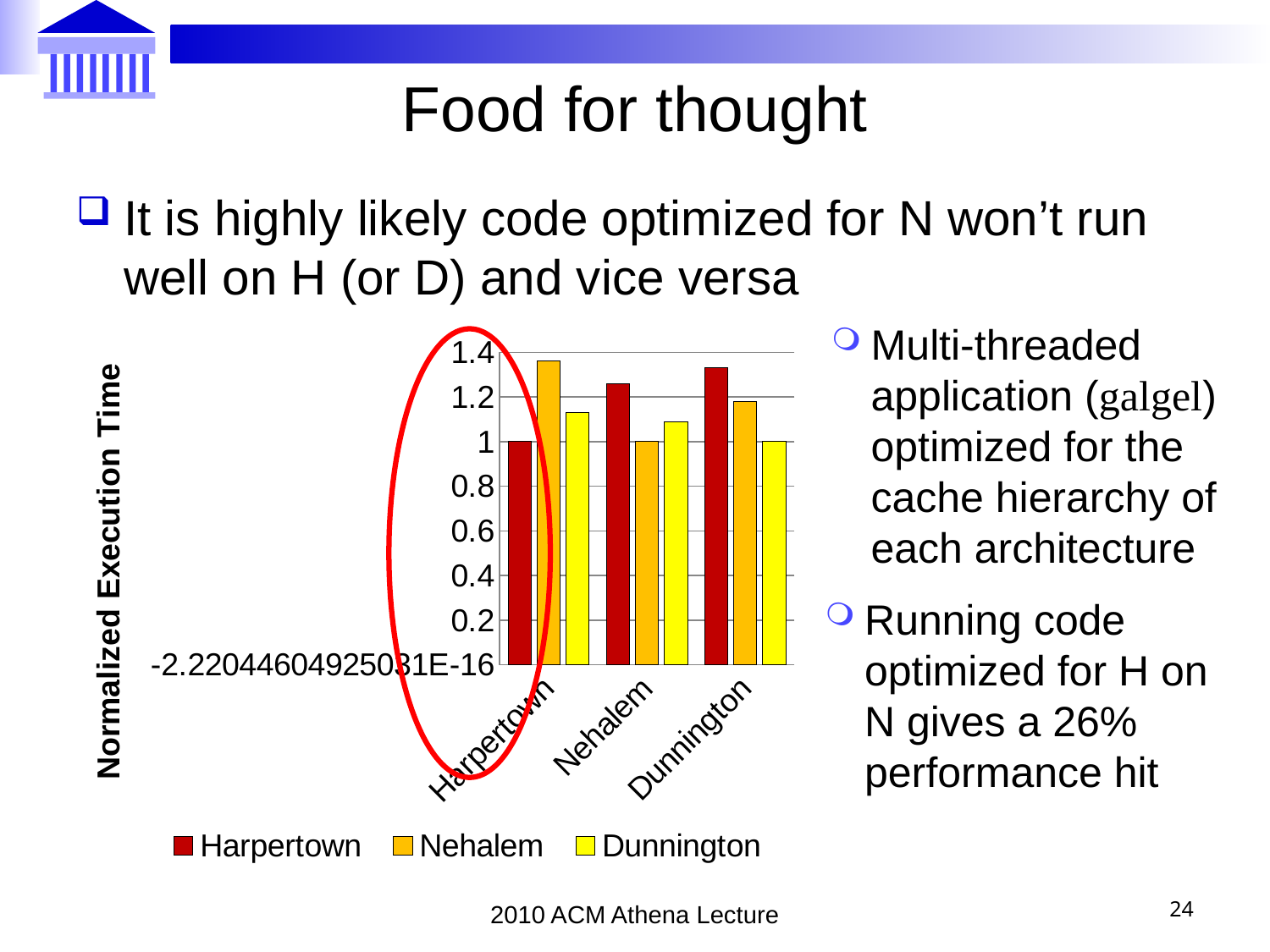
What is the value of the Harpertown series for the Harpertown category? 1 How many series does the chart legend list? 3 Is the value of the Nehalem series for the Harpertown category greater or less than 1.2? greater What is the value of the Nehalem series for the Nehalem category? 1 What is the value of the Dunnington series for the Dunnington category? 1 Is the value of the Nehalem series for the Dunnington category greater or less than 1? greater What kind of chart is shown on the slide? bar chart What is the title of the chart's vertical axis? Normalized Execution Time In the Dunnington category, which is larger: the Harpertown series or the Nehalem series? Harpertown Which series has the highest value in the Harpertown category? Nehalem Is the value of the Dunnington series for the Nehalem category greater or less than 1.2? less How many categories are shown on the x axis of the chart? 3